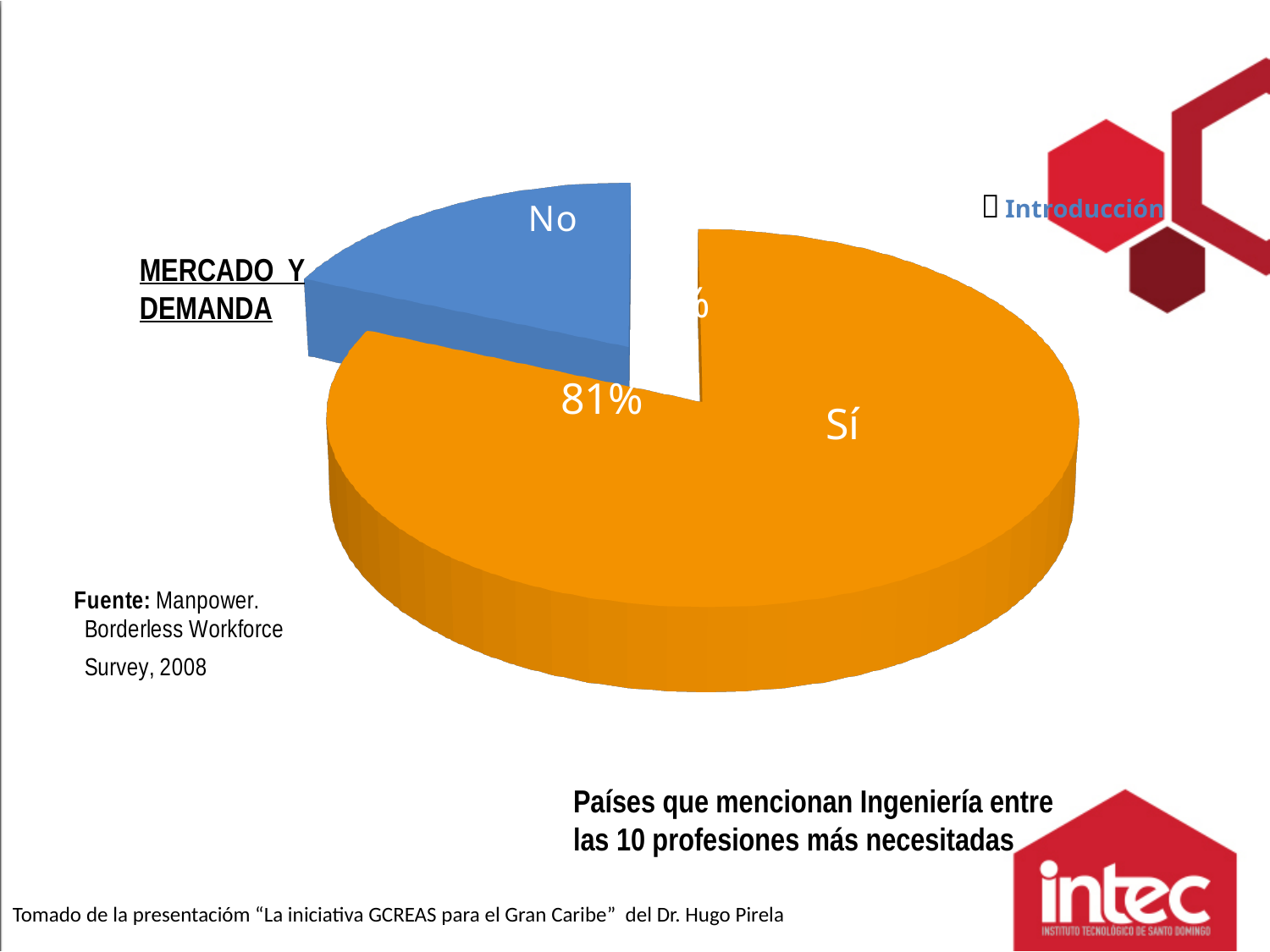
What kind of chart is shown on the slide? pie chart What percentage is shown for the "Sí" slice? 81% Is the share for "Sí" greater or less than 50%? greater Which slice of the pie chart is the largest? Sí What colour is the "Sí" slice of the pie chart? orange Which slice of the pie chart is the smallest? No What is the caption of the pie chart shown below it? Países que mencionan Ingeniería entre las 10 profesiones más necesitadas How many slices does the pie chart have? 2 Which slice is larger, "Sí" or "No"? Sí